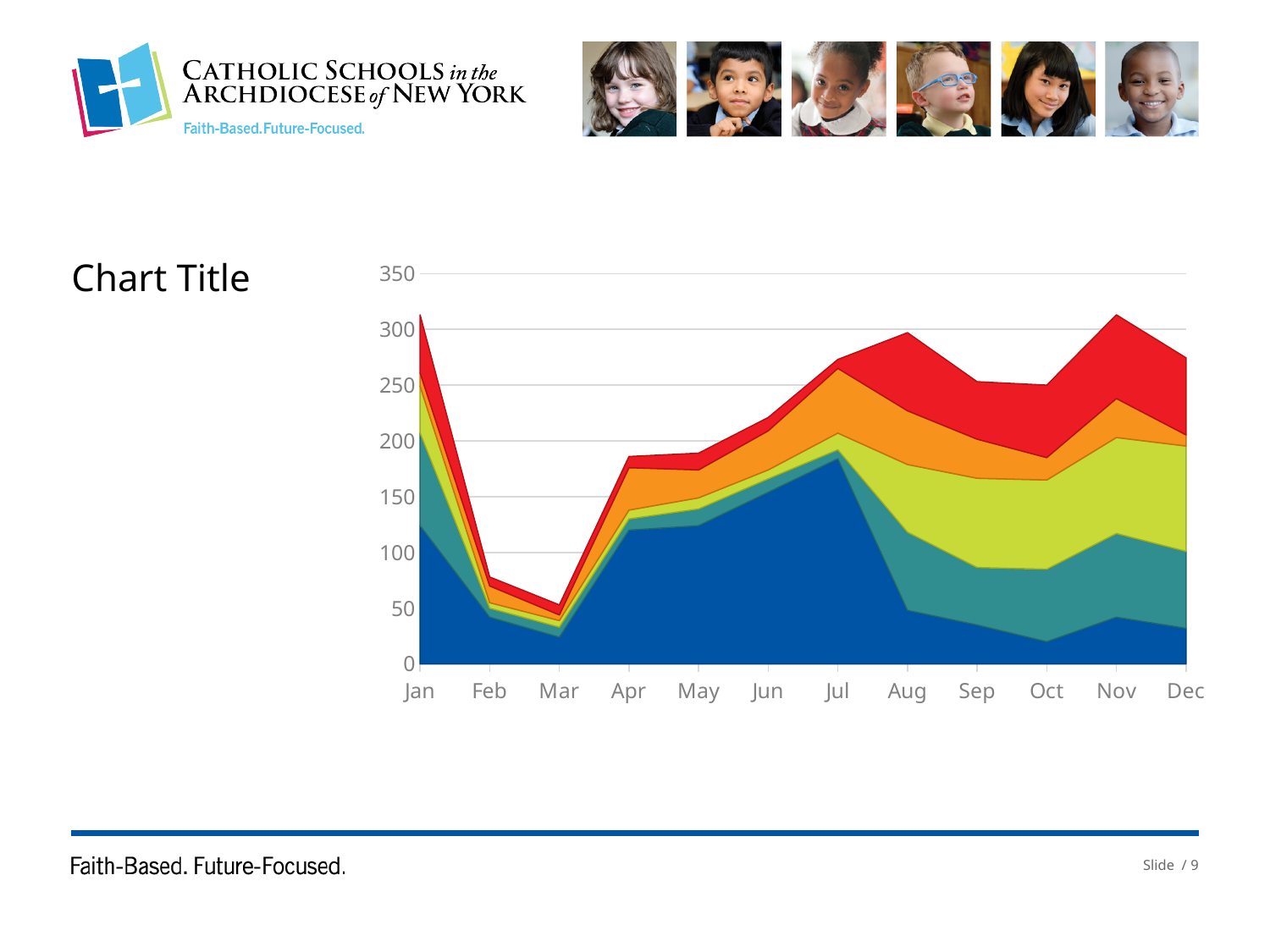
In which month is the stacked total lowest? Mar Does the stacked total rise or fall from Jan to Mar? fall What kind of chart is shown on the slide? Stacked area chart Is the value of the bottom (blue) area for Jul greater or less than 150? greater Is the stacked total for Mar greater or less than 100? less Is the stacked total for Jan greater or less than 300? greater What is the title of the chart? Chart Title In which month does the bottom (blue) area reach its highest value? Jul Does the stacked total rise or fall from Mar to Jul? rise How many coloured areas are stacked in the chart? 5 How many months are shown along the x axis of the chart? 12